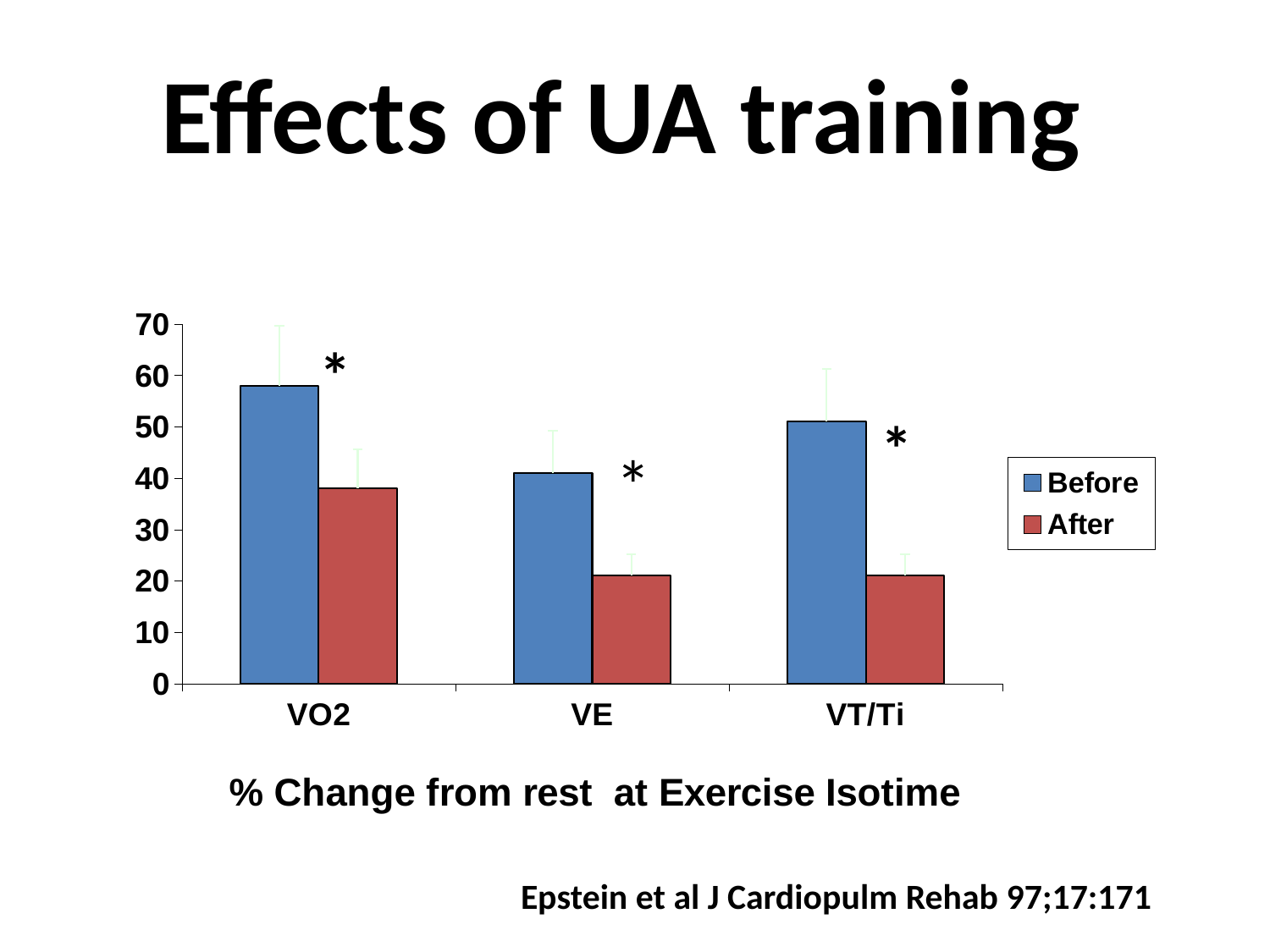
Is the Before value for VO2 greater or less than 50? greater Which category has the highest After value? VO2 How many categories are shown on the x axis? 3 Which category has the highest Before value? VO2 Is the Before value for VT/Ti greater or less than 60? less Is the After value for VE greater or less than 30? less Which category has the lowest Before value? VE What kind of chart is shown on the slide? bar chart What is the x-axis label of the chart? % Change from rest at Exercise Isotime For VE, which is larger, the Before value or the After value? Before Which is larger, the Before value for VO2 or the Before value for VT/Ti? VO2 How many series does the legend list? 2